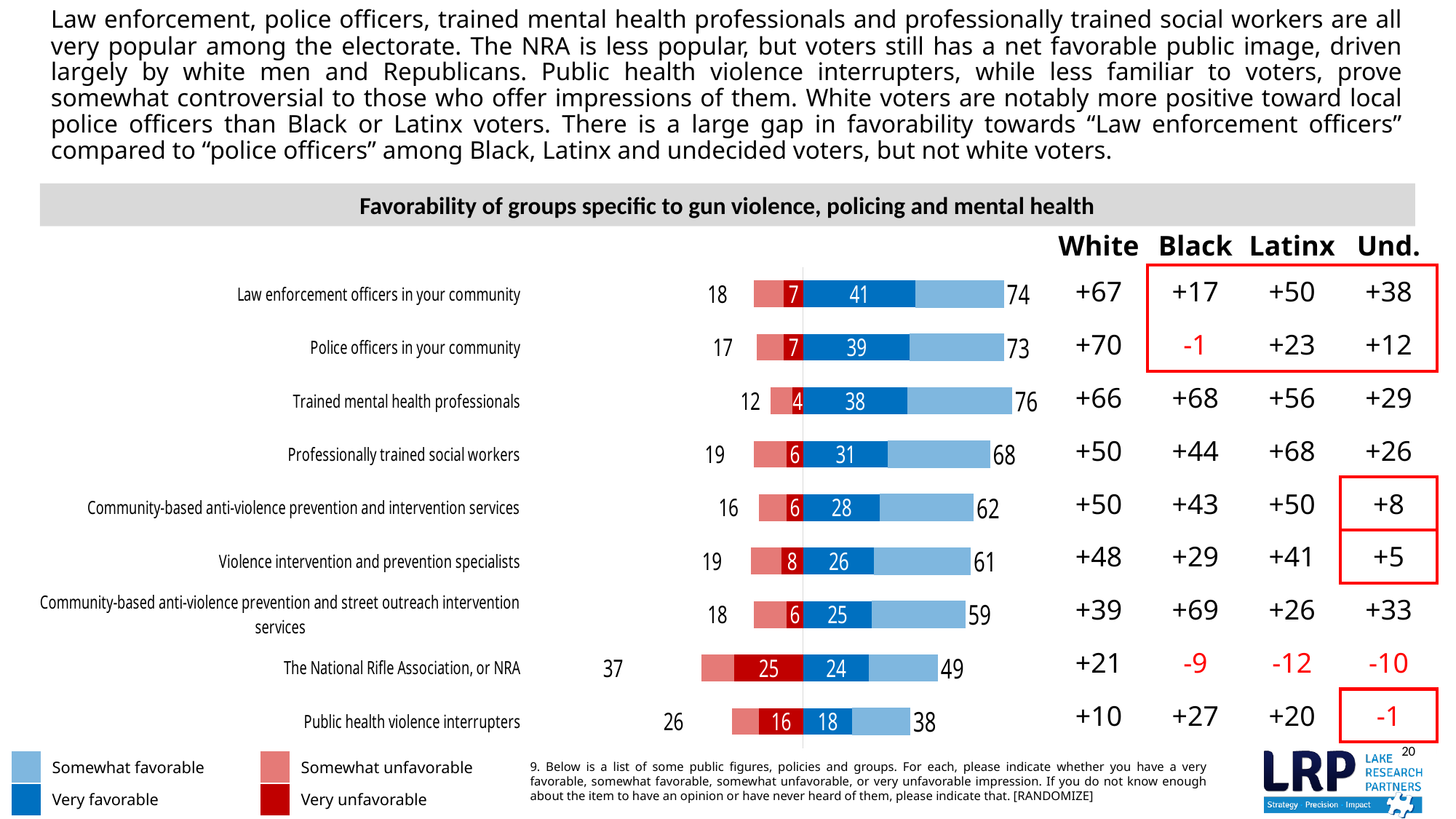
What is the title of the chart? Favorability of groups specific to gun violence, policing and mental health Which has a larger Very favorable value: Law enforcement officers in your community or Police officers in your community? Law enforcement officers in your community What is the total favorable value for Trained mental health professionals? 76 What is the Very unfavorable value for The National Rifle Association, or NRA? 25 How many groups (categories) are plotted in the chart? 9 How many series does the legend list? 4 What is the Very favorable value for Public health violence interrupters? 18 What kind of chart is shown on the slide? bar chart Which group has the lowest total favorable value? Public health violence interrupters What is the total unfavorable value for The National Rifle Association, or NRA? 37 What is the difference between the total favorable (49) and total unfavorable (37) values for The National Rifle Association, or NRA? 12 Which group has the highest total favorable value? Trained mental health professionals